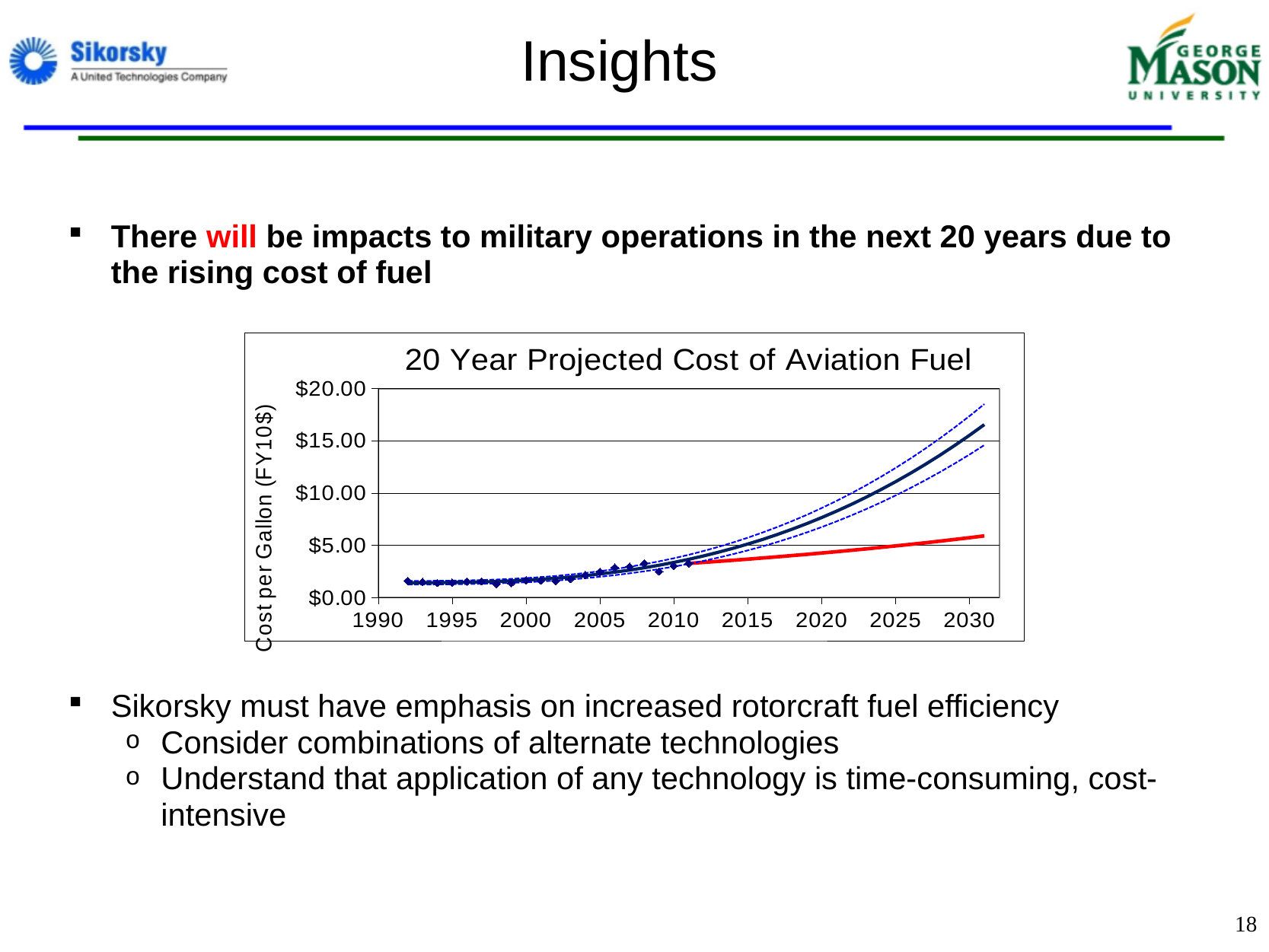
Do the projected fuel cost values rise or fall along the x axis from 1990 to 2030? rise What kind of chart is shown on the slide? line chart At 2030, which line shows the higher cost per gallon: the dark blue solid line or the red line? the dark blue solid line Is the cost per gallon shown for the year 2000 greater or less than $5.00? less Is the value of the red projection line at 2030 greater or less than $10.00? less What is the label of the y axis of the chart? Cost per Gallon (FY10$) Is the upper blue dashed line at 2030 greater or less than $15.00? greater What is the title of the chart? 20 Year Projected Cost of Aviation Fuel